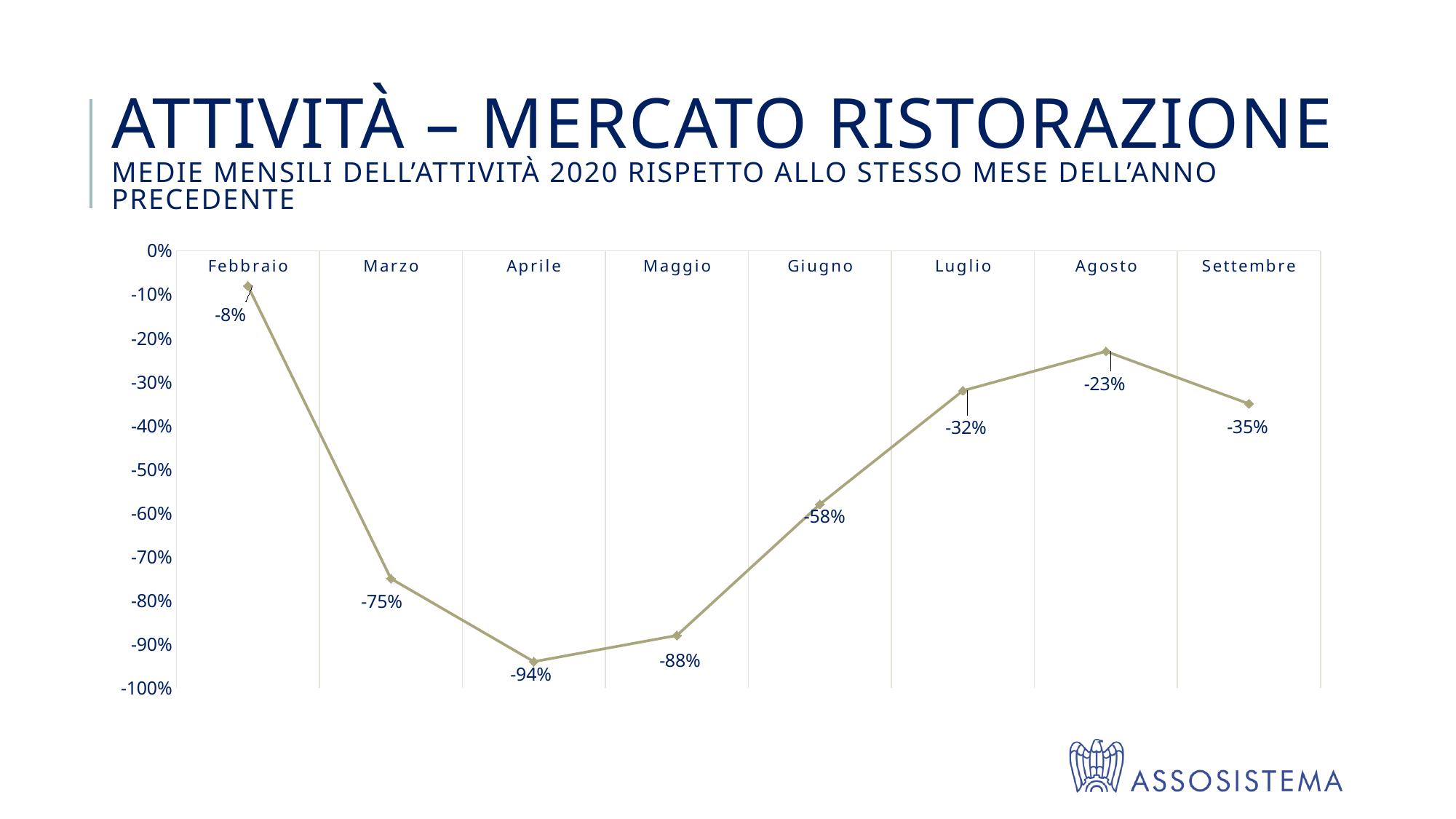
Which month has the highest value? Febbraio What is the title of the slide containing the chart? ATTIVITÀ – MERCATO RISTORAZIONE What is the value for Aprile? -94% What is the difference between the values for Marzo and Febbraio? 67 percentage points Which month has the lowest value? Aprile What kind of chart is shown on the slide? Line chart Which is larger, the value for Luglio or the value for Settembre? Luglio How many months are plotted on the chart? 8 Do the values rise or fall from Aprile to Agosto? Rise What is the value for Agosto? -23% Is the value for Maggio greater or less than -80%? less What is the value for Giugno? -58%